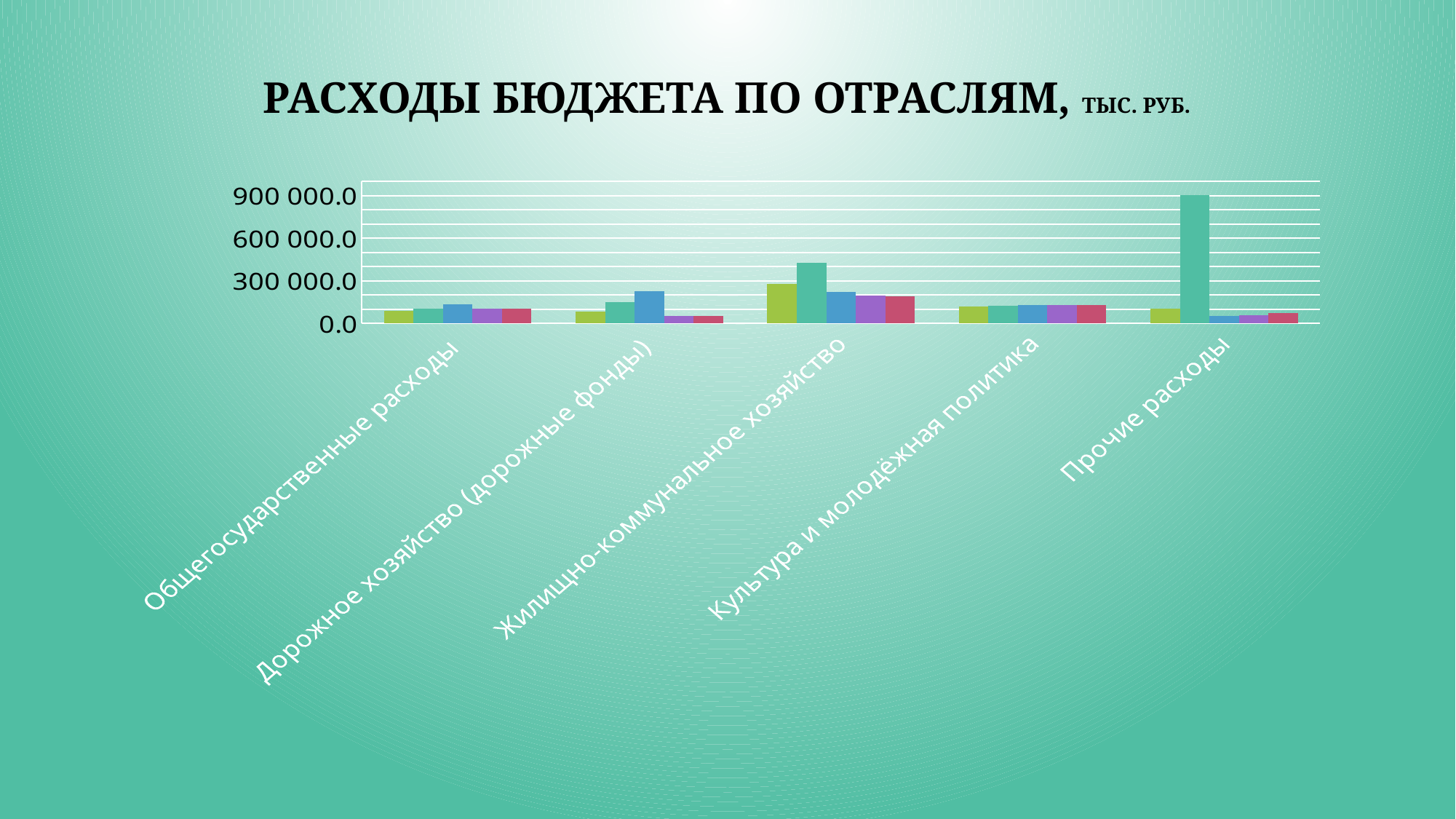
How many categories are shown on the x axis of the chart? 5 Which category contains the tallest bar in the chart? Прочие расходы Is the tallest bar in the 'Прочие расходы' category greater or less than 600 000.0? greater Is the tallest bar in the 'Жилищно-коммунальное хозяйство' category greater or less than 600 000.0? less Is the tallest bar in the 'Дорожное хозяйство (дорожные фонды)' category greater or less than 300 000.0? less How many bars are plotted for each category in the chart? 5 Which category has the taller teal bar: 'Жилищно-коммунальное хозяйство' or 'Дорожное хозяйство (дорожные фонды)'? Жилищно-коммунальное хозяйство What kind of chart is shown on the slide? Bar chart What is the title of the chart on the slide? РАСХОДЫ БЮДЖЕТА ПО ОТРАСЛЯМ, ТЫС. РУБ. What is the highest value labelled on the vertical axis of the chart? 900 000.0